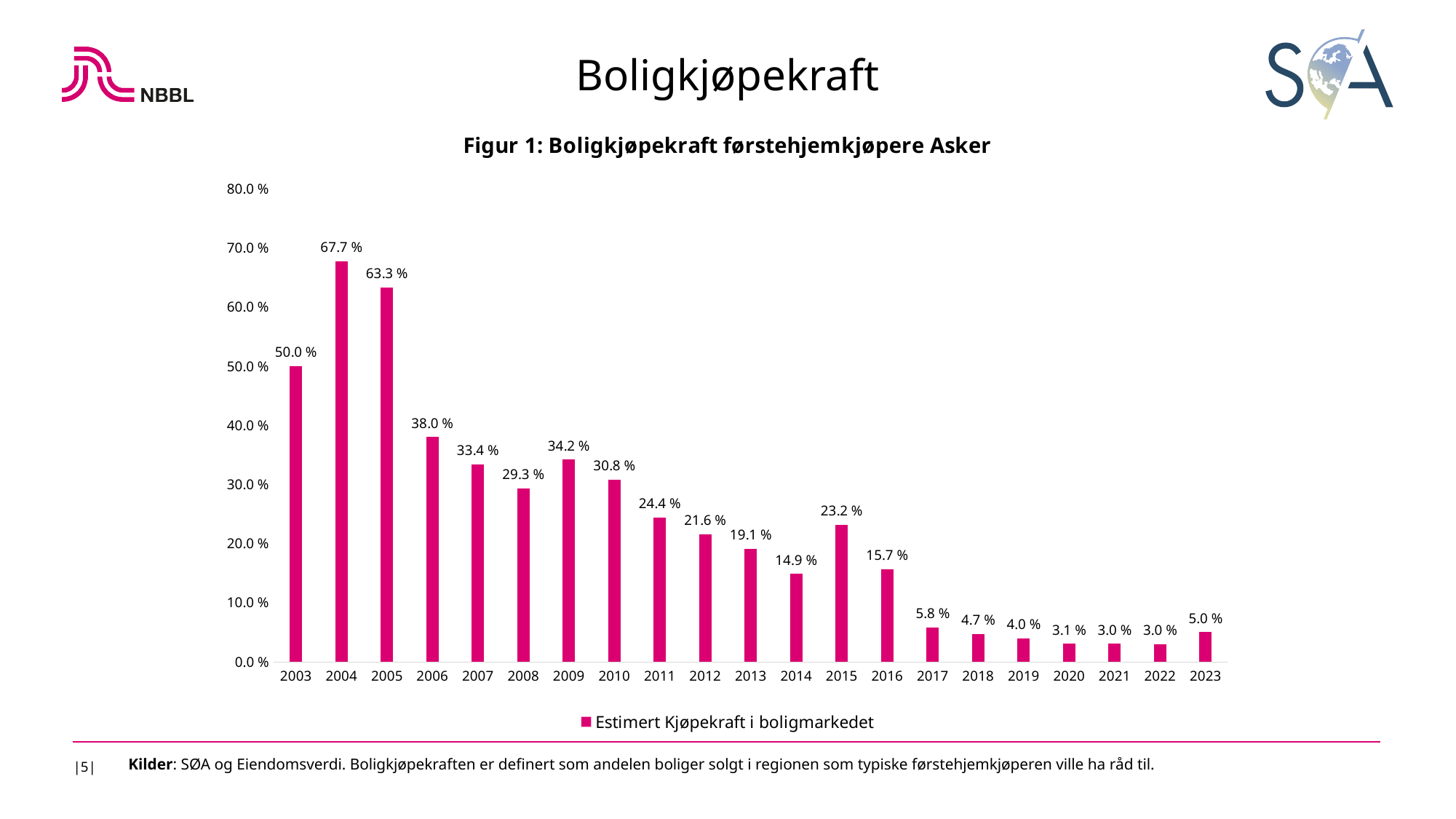
What is the value for 2004? 67.7 % Which is larger, the value for 2009 or the value for 2010? 2009 Which year has the highest value? 2004 What is the value for 2015? 23.2 % How many years are shown on the x axis? 21 What is the title of the chart? Figur 1: Boligkjøpekraft førstehjemkjøpere Asker Is the value for 2005 greater or less than 60.0 %? greater Which year has the lowest value? 2021 and 2022 (3.0 %) How many series does the legend list? 1 What is the value for 2023? 5.0 % What is the difference between the values for 2003 and 2006? 12.0 % What kind of chart is this? bar chart